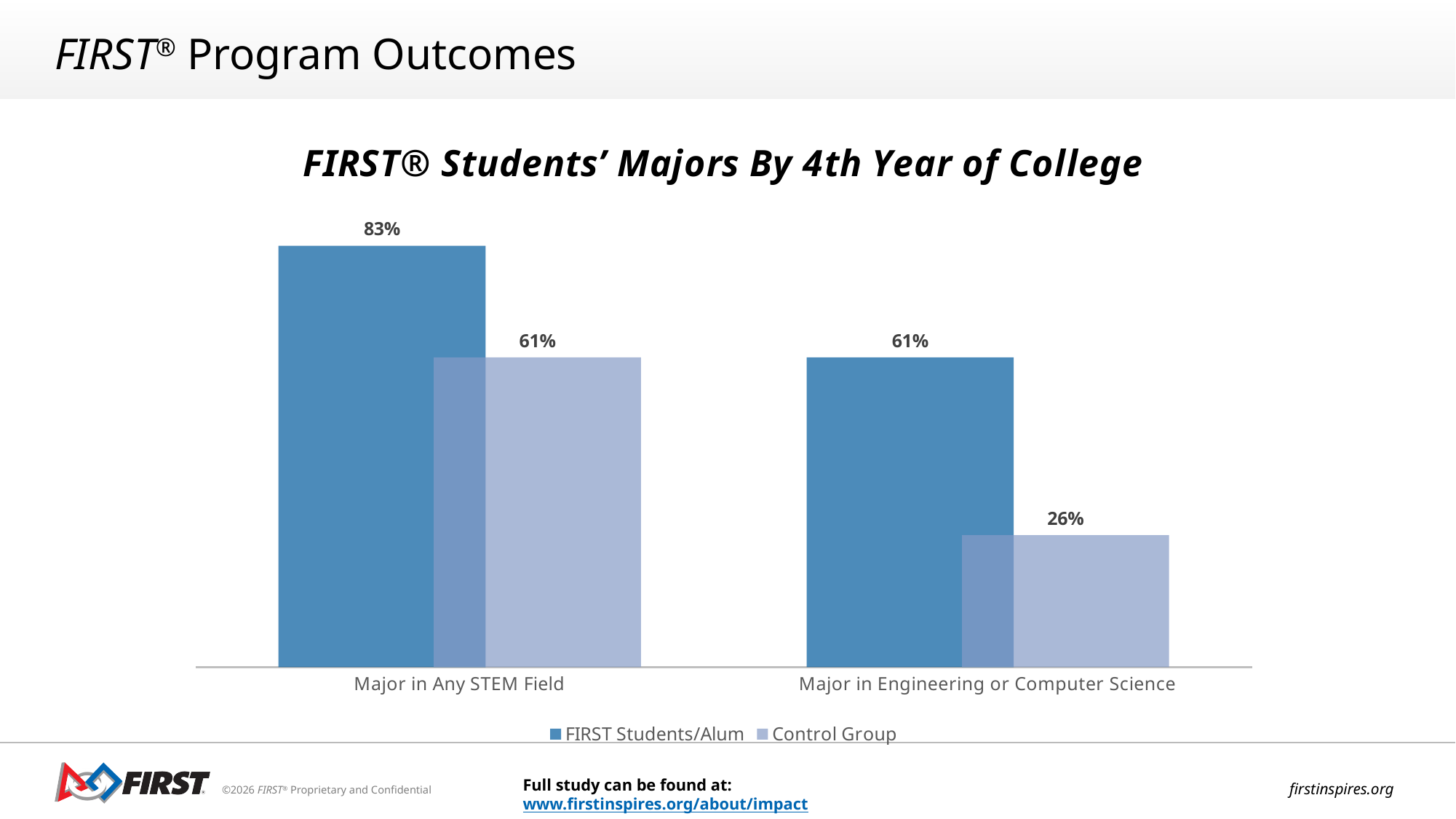
What is the title of the chart? FIRST® Students' Majors By 4th Year of College What is the value for FIRST Students/Alum in the Major in Any STEM Field category? 83% Which series has the lowest value in the Major in Engineering or Computer Science category? Control Group What is the difference between FIRST Students/Alum and the Control Group in the Major in Engineering or Computer Science category? 35% What is the value for the Control Group in the Major in Any STEM Field category? 61% What is the difference between FIRST Students/Alum and the Control Group in the Major in Any STEM Field category? 22% What is the value for FIRST Students/Alum in the Major in Engineering or Computer Science category? 61% Which is larger: the FIRST Students/Alum value for Major in Engineering or Computer Science, or the Control Group value for Major in Any STEM Field? They are equal (61%) How many series does the legend list? 2 What is the value for the Control Group in the Major in Engineering or Computer Science category? 26% How many categories are shown on the x axis? 2 What kind of chart is shown on the slide? Bar chart